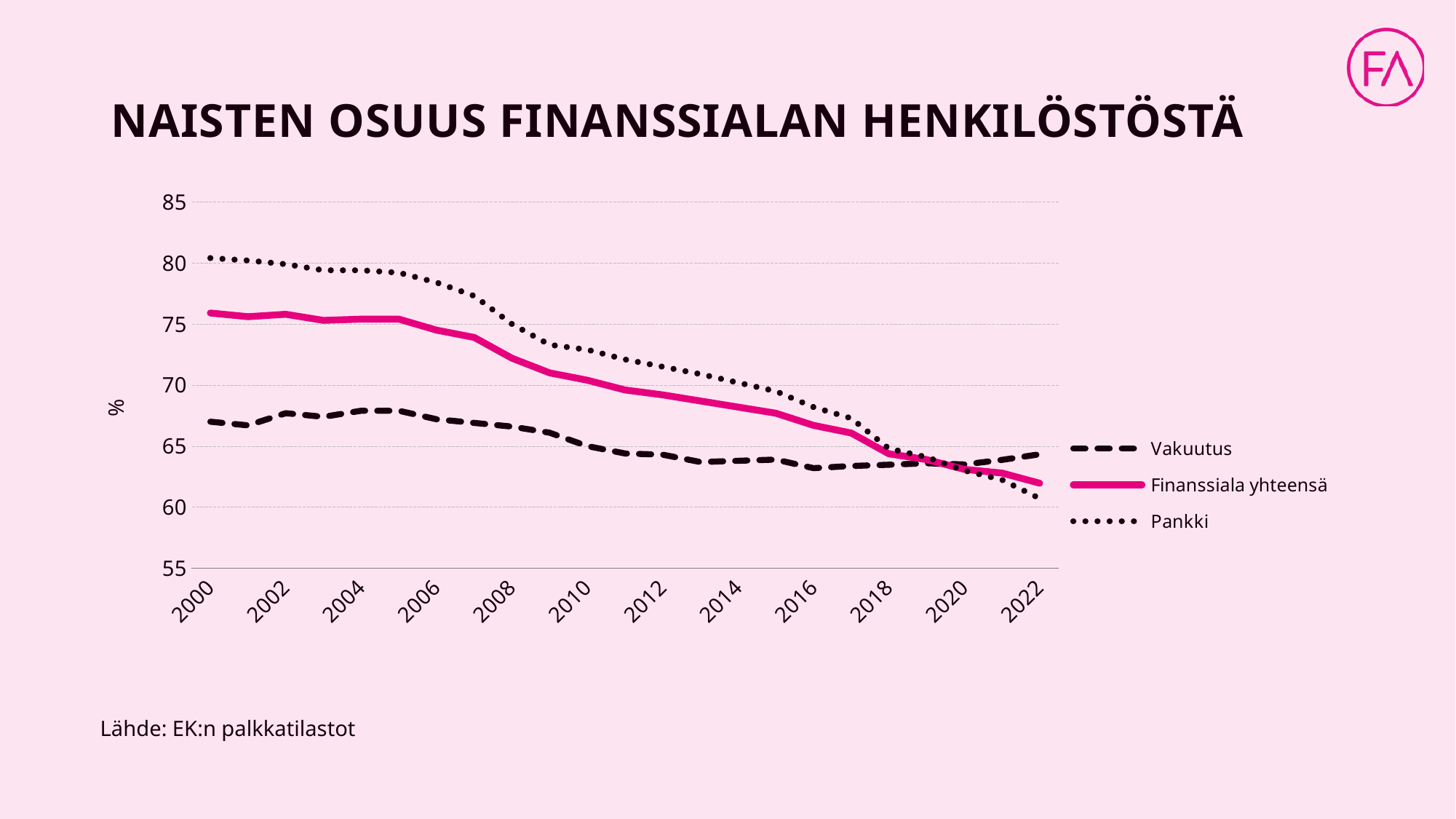
Which series is highest in 2000? Pankki Which series is lowest in 2022? Pankki What kind of chart is shown on the slide? line chart Which series is drawn as a solid pink line? Finanssiala yhteensä What is the title of the chart? NAISTEN OSUUS FINANSSIALAN HENKILÖSTÖSTÄ Does the Pankki series rise or fall from 2000 to 2022? fall Is the value for Pankki in 2000 greater or less than 80? greater Is the value for Finanssiala yhteensä in 2000 greater or less than 75? greater Is the value for Pankki in 2010 greater or less than 70? greater How many series does the legend list? 3 In 2022, which is larger: Vakuutus or Pankki? Vakuutus